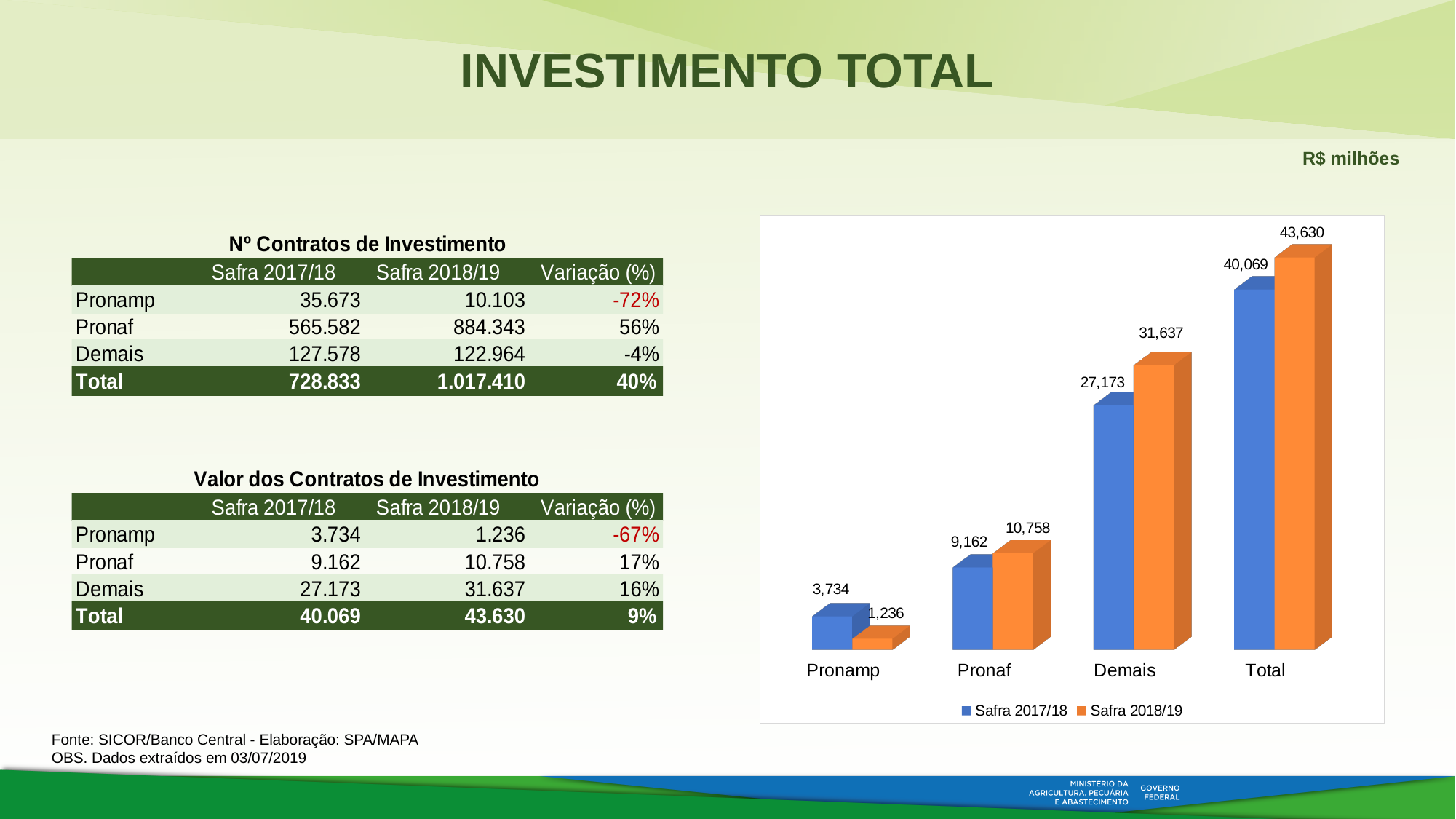
Which category has the lowest value in the Safra 2017/18 series? Pronamp For Pronaf, which series has the larger value, Safra 2017/18 or Safra 2018/19? Safra 2018/19 How many categories are shown on the x axis of the chart? 4 How many series does the chart legend list? 2 What is the value for Pronamp in the Safra 2018/19 series? 1,236 What is the value for Total in the Safra 2018/19 series? 43,630 What is the value for Demais in the Safra 2017/18 series? 27,173 What is the value for Pronaf in the Safra 2018/19 series? 10,758 What kind of chart is shown on the slide? Bar chart Which category has the highest value in the Safra 2018/19 series? Total What is the difference between the Safra 2018/19 and Safra 2017/18 values for Demais? 4,464 What is the difference between the Safra 2017/18 and Safra 2018/19 values for Pronamp? 2,498